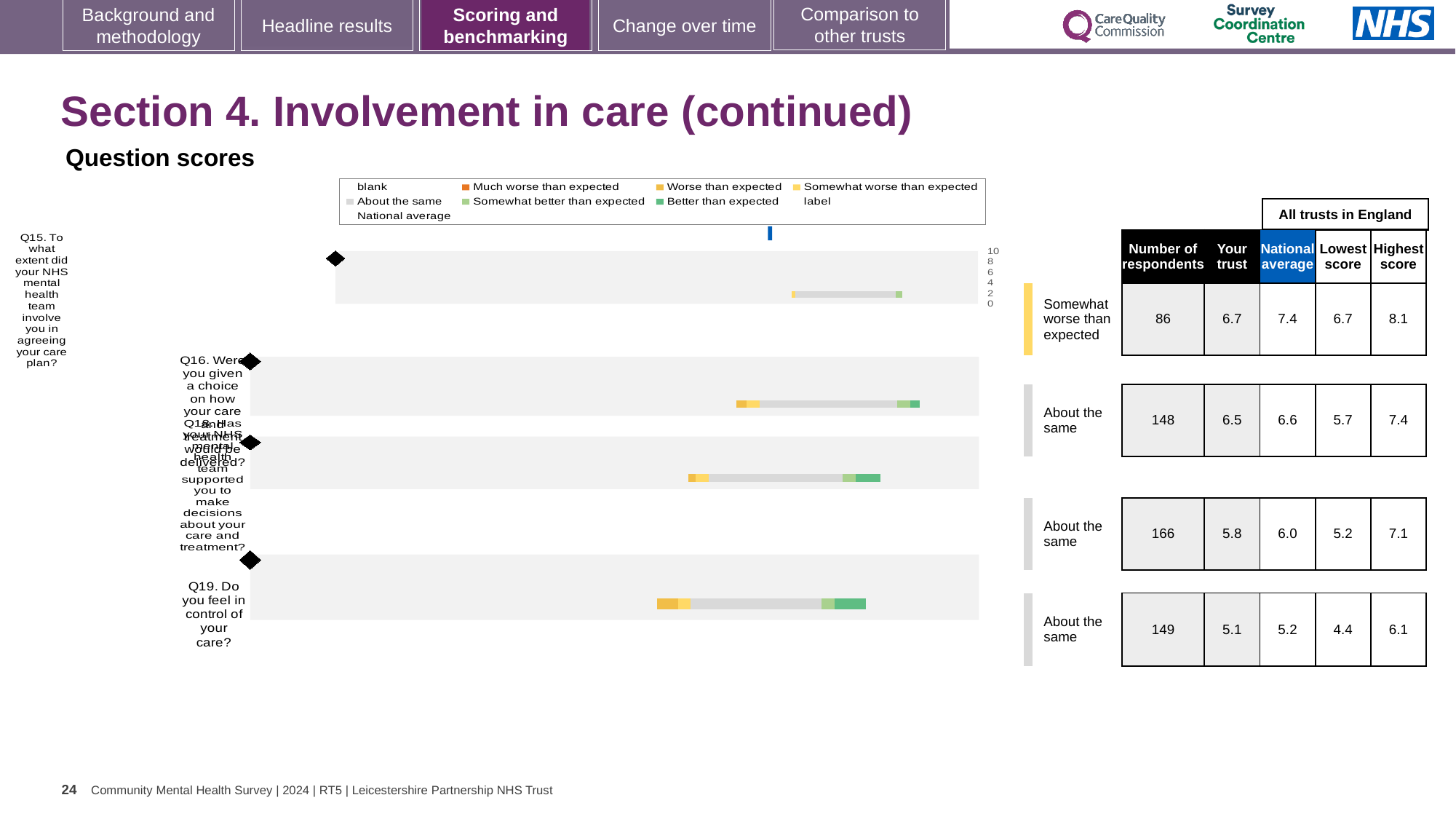
For Q15, which is larger: the 'Your trust' score or the national average? National average What is the national average score for Q19 (feeling in control of your care)? 5.2 What is the difference between the national average and the 'Your trust' score for Q19? 0.1 What benchmark category is shown for Q15? Somewhat worse than expected Which question has the lowest 'Your trust' score? Q19 Which question has the highest 'Your trust' score? Q15 What is the 'Your trust' score for Q15 (involvement in agreeing your care plan)? 6.7 For Q16, what is the difference between the highest score and the lowest score among all trusts in England? 1.7 How many questions are plotted in the question scores chart? 4 How many respondents answered Q18 (supported to make decisions about care and treatment)? 166 What is the heading above the chart on this slide? Question scores What kind of chart is used to show the question scores on this slide? bar chart